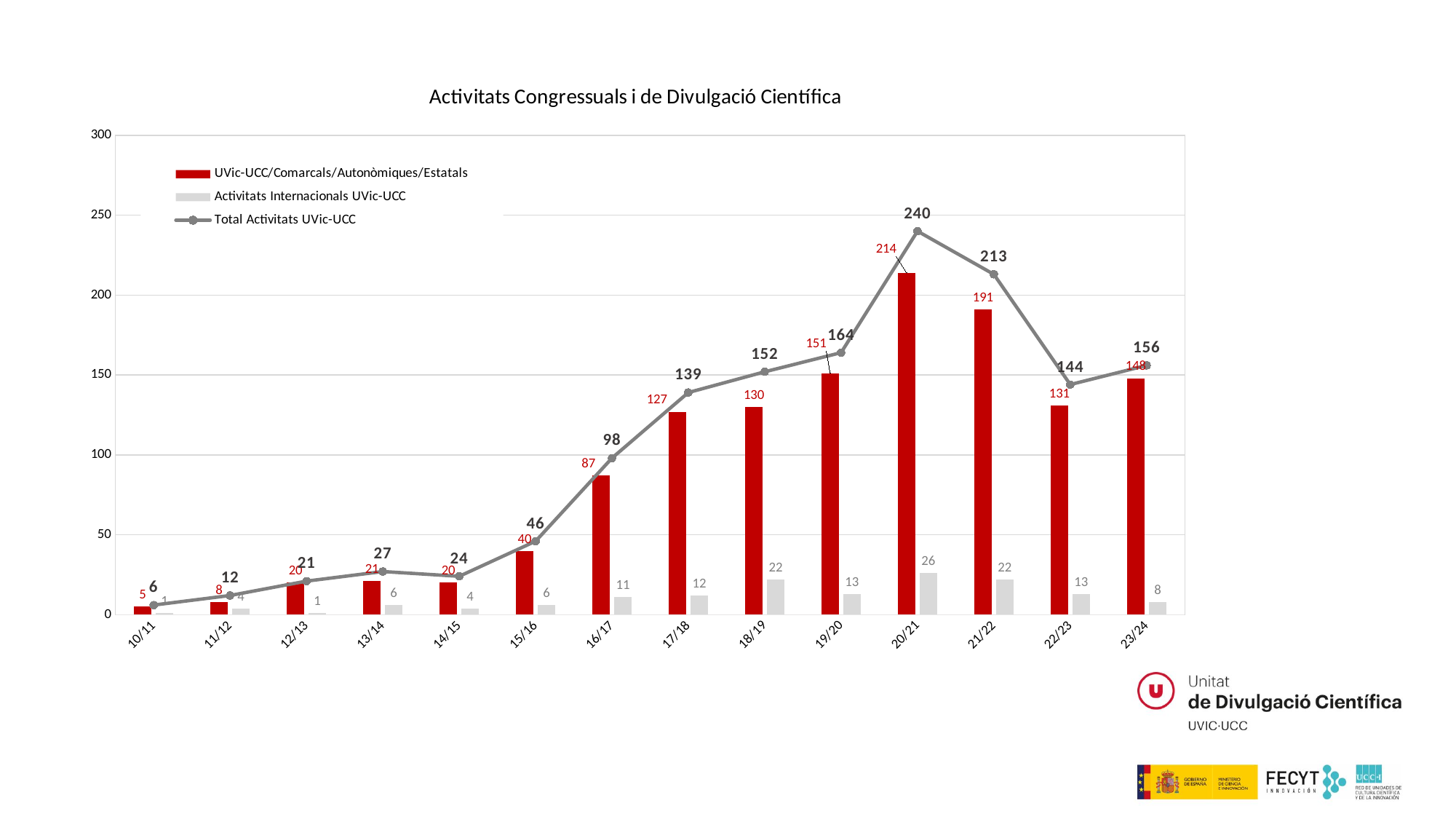
How many academic years are shown on the x axis? 14 What is the difference between the Total Activitats UVic-UCC for 20/21 and 21/22? 27 Which academic year has the highest Total Activitats UVic-UCC? 20/21 Is the value of UVic-UCC/Comarcals/Autonòmiques/Estatals for 21/22 greater or less than 200? less Which is larger: the Activitats Internacionals UVic-UCC value for 20/21 or for 23/24? 20/21 Which academic year has the lowest value for UVic-UCC/Comarcals/Autonòmiques/Estatals? 10/11 What kind of chart is this? Combined bar and line chart What is the value of UVic-UCC/Comarcals/Autonòmiques/Estatals for 17/18? 127 What is the value of Total Activitats UVic-UCC for 20/21? 240 What is the value of Activitats Internacionals UVic-UCC for 18/19? 22 How many series does the legend list? 3 What is the title of the chart? Activitats Congressuals i de Divulgació Científica